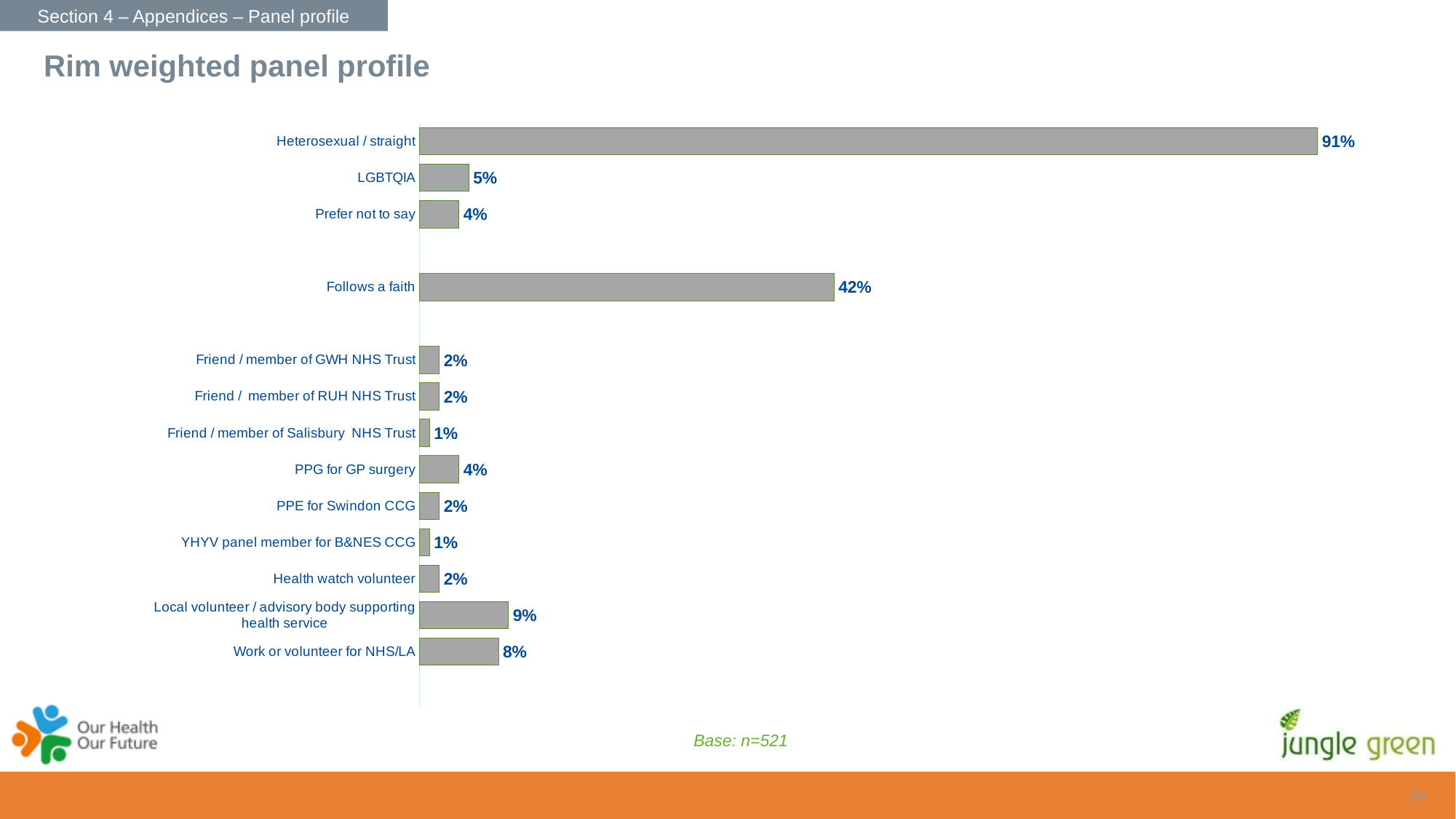
What is the value for Heterosexual / straight? 91% What is the value for Follows a faith? 42% Which is larger, the value for Follows a faith or the value for Work or volunteer for NHS/LA? Follows a faith What is the base size stated below the chart? n=521 Which is larger, the value for LGBTQIA or the value for Prefer not to say? LGBTQIA What kind of chart is shown on the slide? Bar chart What is the value for PPG for GP surgery? 4% What is the difference between the values for Local volunteer / advisory body supporting health service and Work or volunteer for NHS/LA? 1% What is the value for Local volunteer / advisory body supporting health service? 9% Which category has the highest value? Heterosexual / straight What is the difference between the values for Heterosexual / straight and LGBTQIA? 86% How many categories are plotted on the chart? 14